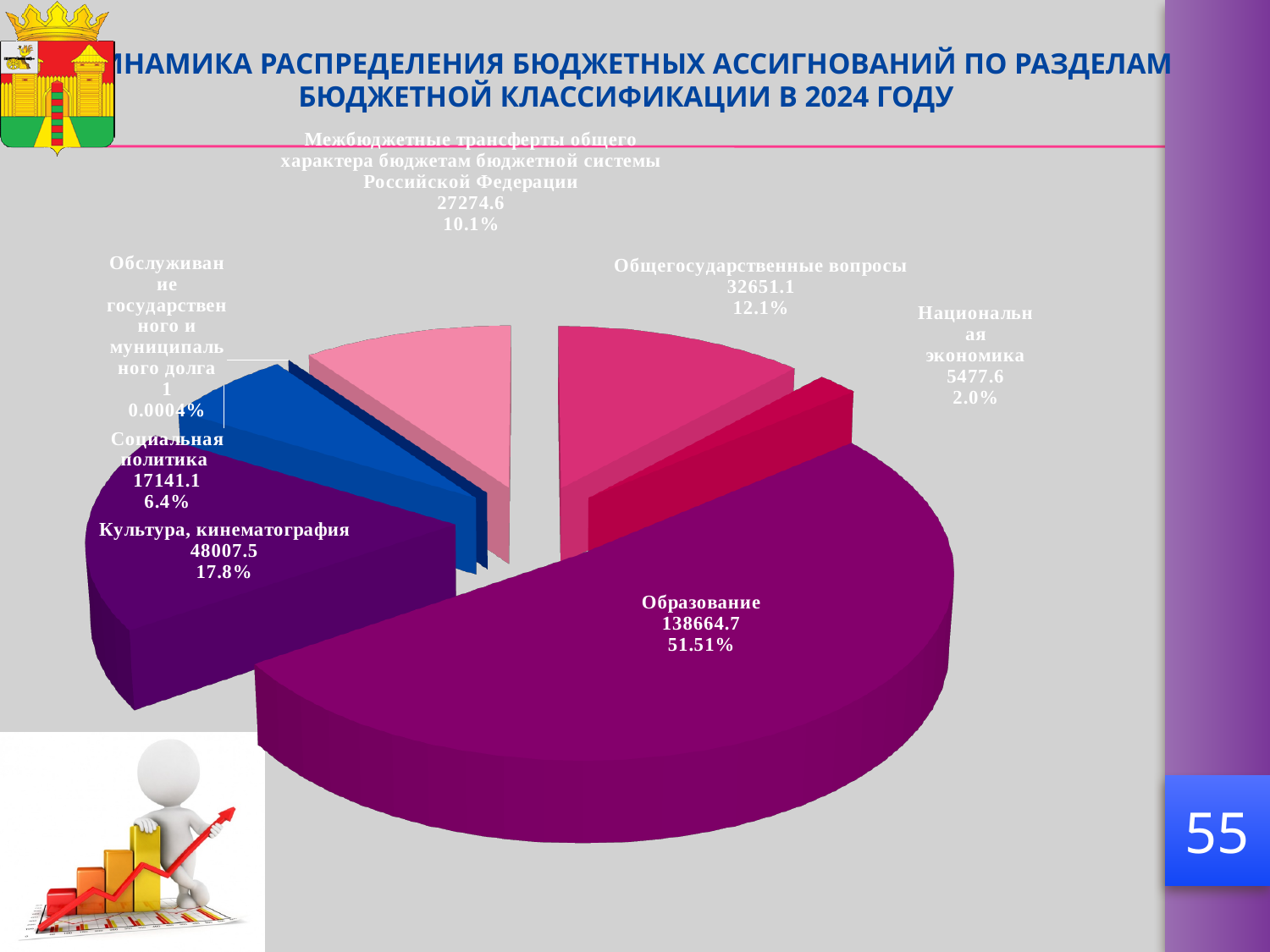
What percentage is shown for Национальная экономика? 2.0% What percentage is shown for Социальная политика? 6.4% What is the value shown for Культура, кинематография? 48007.5 What kind of chart is shown on the slide? Pie chart What is the value shown for Образование? 138664.7 Which category has the largest slice of the pie? Образование How many categories (slices) does the pie chart show? 7 What is the value shown for Общегосударственные вопросы? 32651.1 What is the difference between the values for Культура, кинематография and Социальная политика? 30866.4 What share of the pie does Образование represent? 51.51% Which category has the smallest slice of the pie? Обслуживание государственного и муниципального долга Which is larger: the value for Общегосударственные вопросы or the value for Межбюджетные трансферты общего характера бюджетам бюджетной системы Российской Федерации? Общегосударственные вопросы